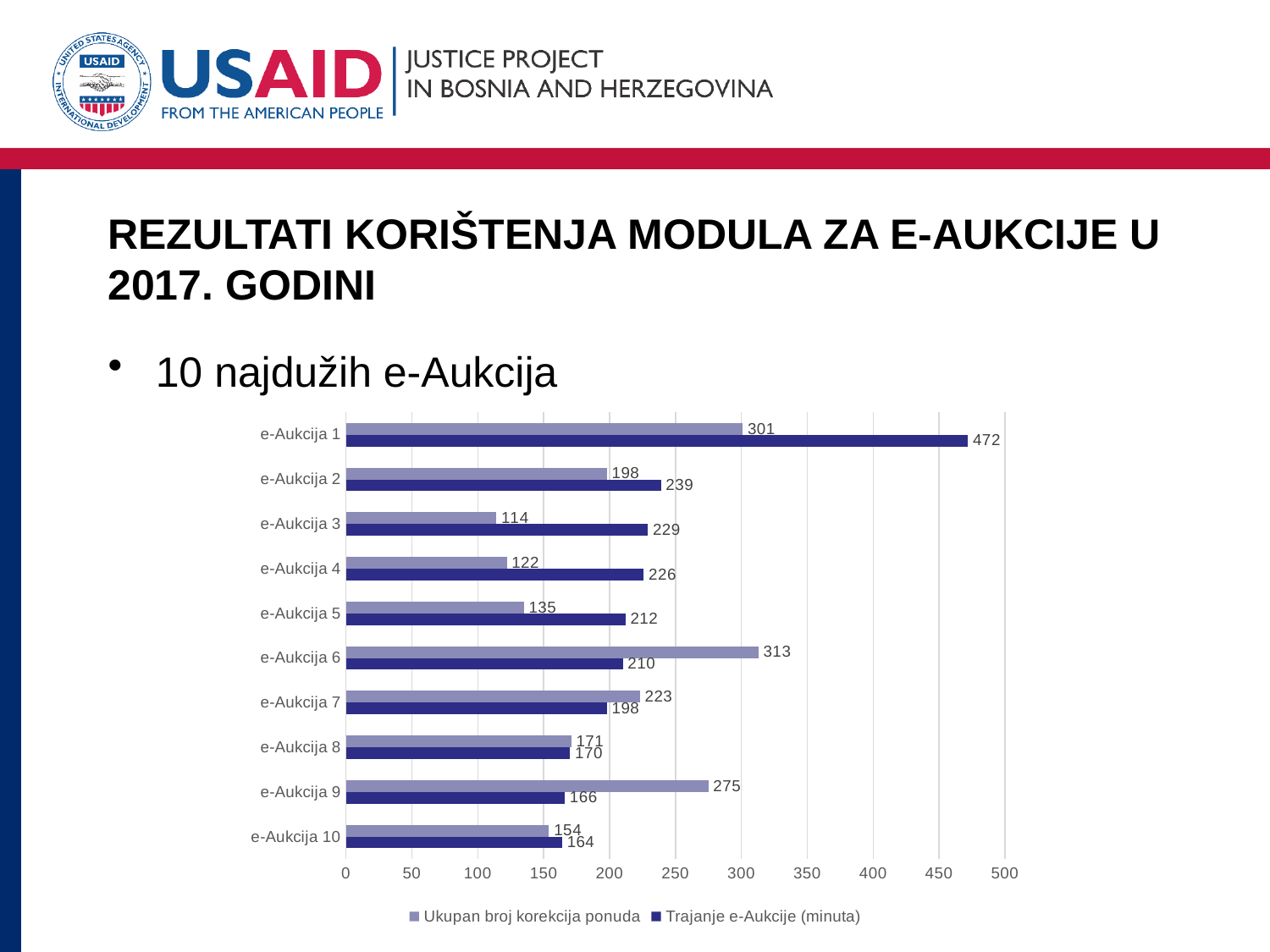
What is the value of Trajanje e-Aukcije (minuta) for e-Aukcija 1? 472 Which category has the lowest value for Ukupan broj korekcija ponuda? e-Aukcija 3 What is the difference between Trajanje e-Aukcije (minuta) for e-Aukcija 1 and e-Aukcija 2? 233 Does the value of Trajanje e-Aukcije (minuta) rise or fall from e-Aukcija 1 to e-Aukcija 10? Fall How many categories (e-Aukcije) are shown on the chart? 10 Which category has the highest value for Trajanje e-Aukcije (minuta)? e-Aukcija 1 What is the value of Ukupan broj korekcija ponuda for e-Aukcija 6? 313 What is the value of Ukupan broj korekcija ponuda for e-Aukcija 3? 114 Which category has the lowest value for Trajanje e-Aukcije (minuta)? e-Aukcija 10 What kind of chart is shown on the slide? Bar chart How many series does the legend list? 2 Which is larger for e-Aukcija 9: Ukupan broj korekcija ponuda or Trajanje e-Aukcije (minuta)? Ukupan broj korekcija ponuda